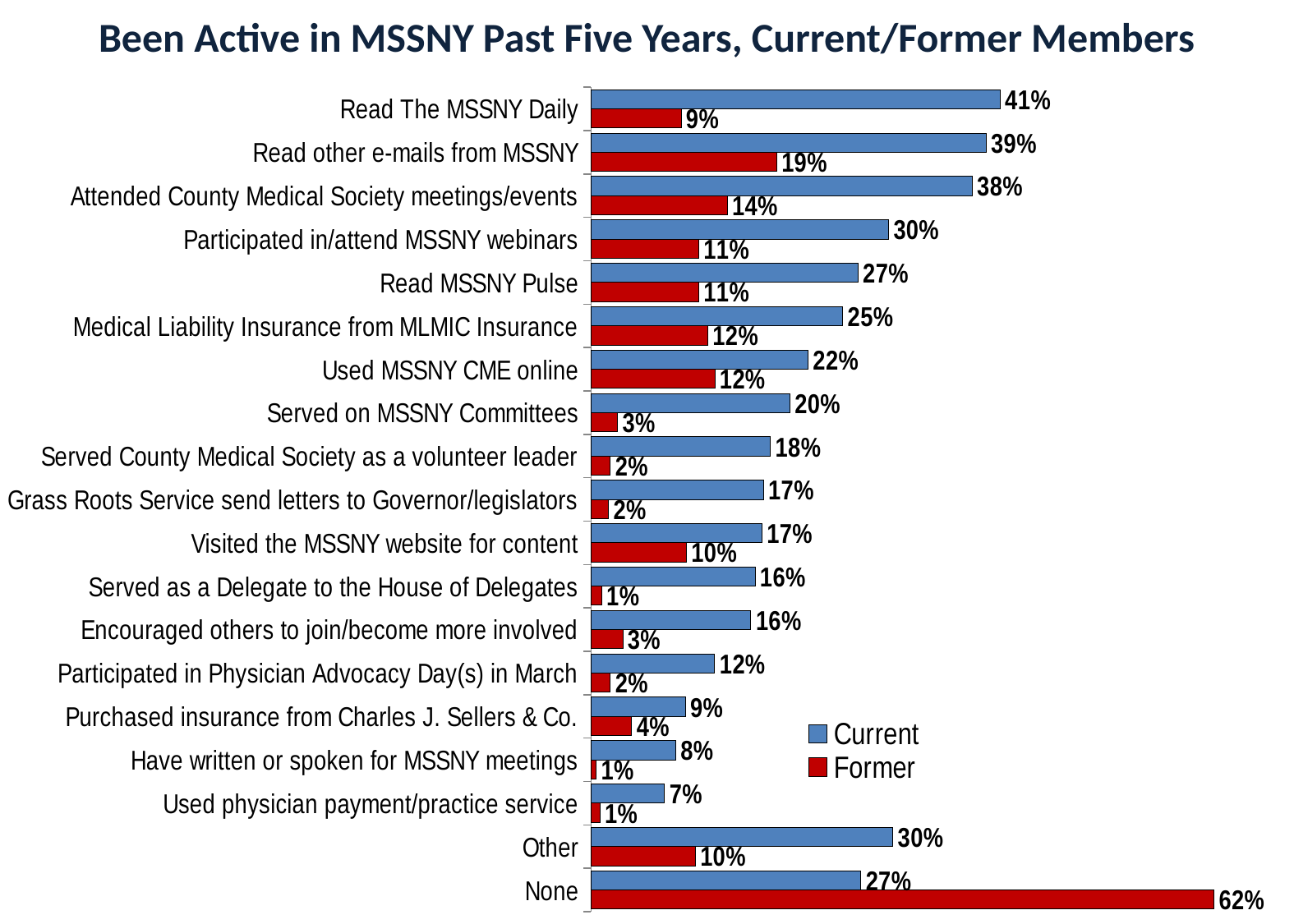
How many series does the legend list? 2 What is the Former value for None? 62% Which category has the highest Former value? None Which category has the highest Current value? Read The MSSNY Daily What kind of chart is this? Bar chart What is the Current value for Used MSSNY CME online? 22% What is the difference between the Current and Former values for Attended County Medical Society meetings/events? 24% Which is larger for Served on MSSNY Committees, the Current value or the Former value? Current What is the Former value for Read other e-mails from MSSNY? 19% How many categories are shown on the chart? 19 What is the Current value for Read The MSSNY Daily? 41% What colour represents the Former series? Red